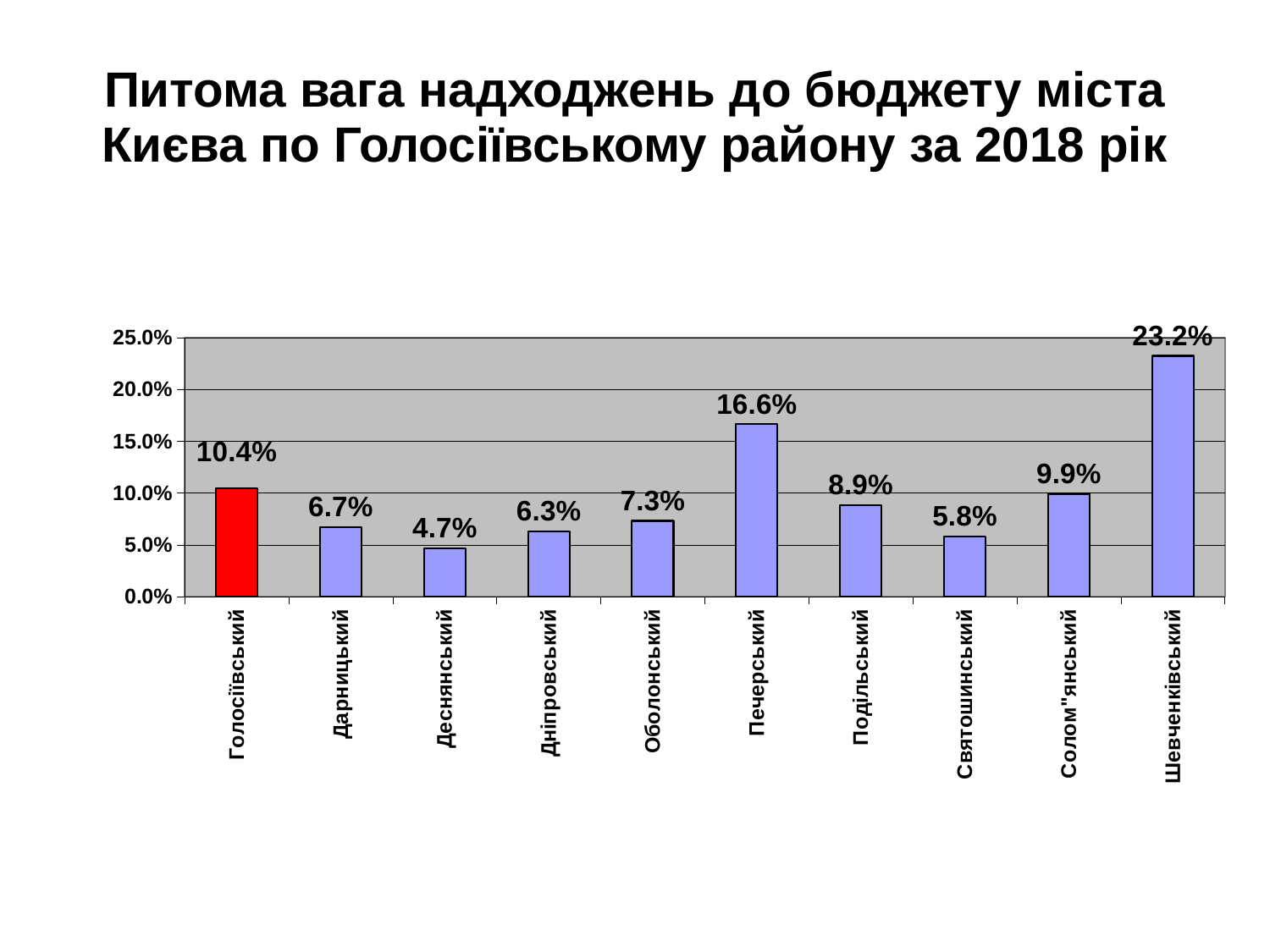
Which district has the lowest value? Деснянський What is the difference between the values for Шевченківський and Голосіївський? 12.8% Which is larger, the value for Дарницький or the value for Оболонський? Оболонський What is the difference between the values for Подільський and Дніпровський? 2.6% Which district has the highest value? Шевченківський Is the value for Печерський greater or less than 15.0%? greater What is the value for Голосіївський? 10.4% What kind of chart is shown on the slide? bar chart What is the value for Печерський? 16.6% What is the value for Святошинський? 5.8% How many districts are shown on the chart? 10 Which bar is coloured red? Голосіївський